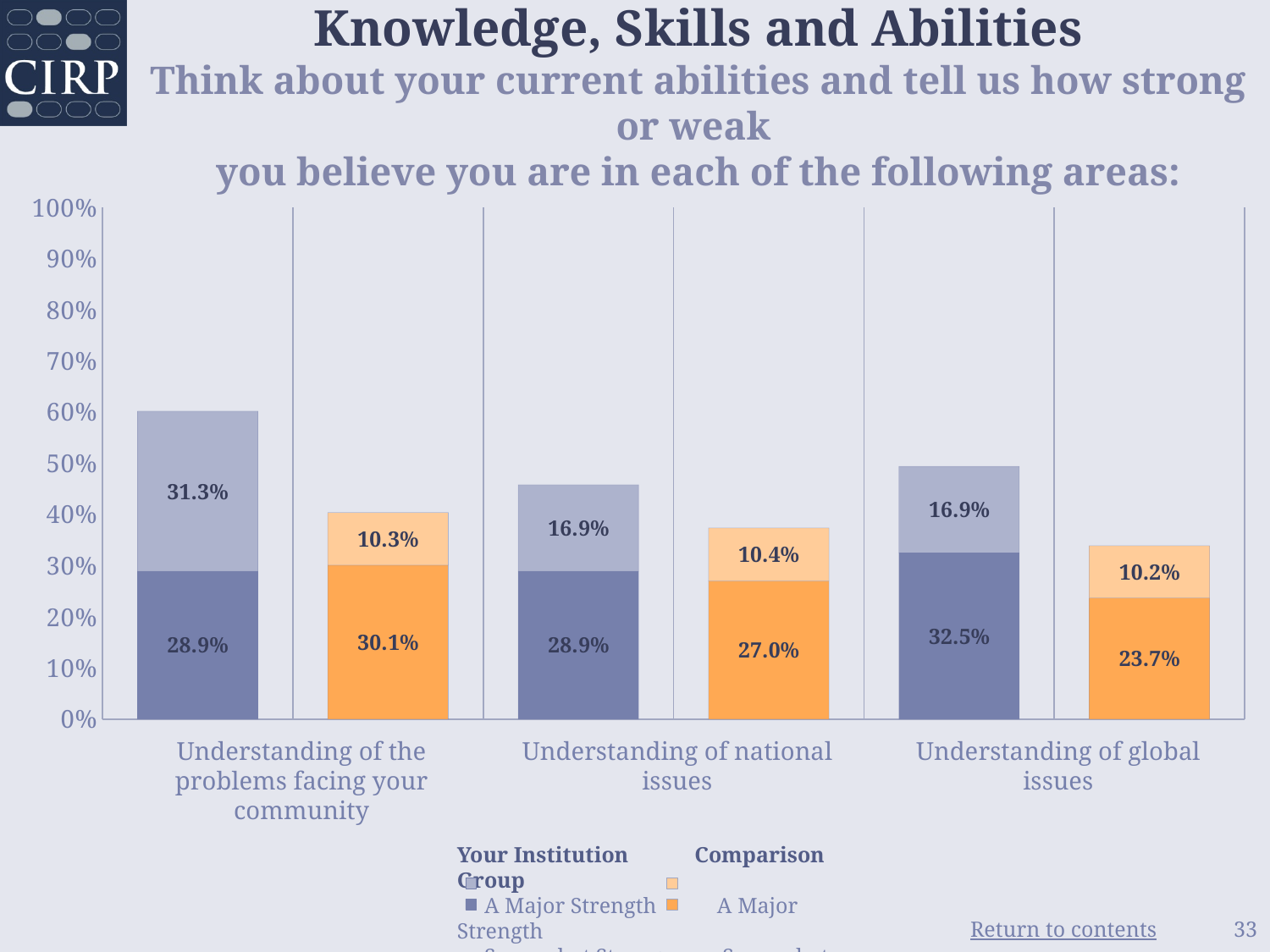
How many areas (categories) are shown on the x axis of the chart? 3 What is the total of the stacked Your Institution bar for 'Understanding of global issues'? 49.4% What is the total of the stacked Comparison Group bar for 'Understanding of national issues'? 37.4% Across the three areas, which has the highest A Major Strength value for Your Institution? Understanding of global issues For 'Understanding of the problems facing your community', which has the larger A Major Strength value: Your Institution or the Comparison Group? Comparison Group What percentage of students at Your Institution rated 'Understanding of global issues' as A Major Strength? 32.5% Across the three areas, which has the lowest A Major Strength value for the Comparison Group? Understanding of global issues What is the difference between Your Institution's and the Comparison Group's A Major Strength values for 'Understanding of global issues'? 8.8% What is the lighter (upper) segment value for Your Institution in 'Understanding of the problems facing your community'? 31.3% What type of chart is shown on the slide? Stacked bar chart Is the total height of the Your Institution bar for 'Understanding of the problems facing your community' greater or less than 50%? greater What is the Comparison Group's A Major Strength value for 'Understanding of national issues'? 27.0%